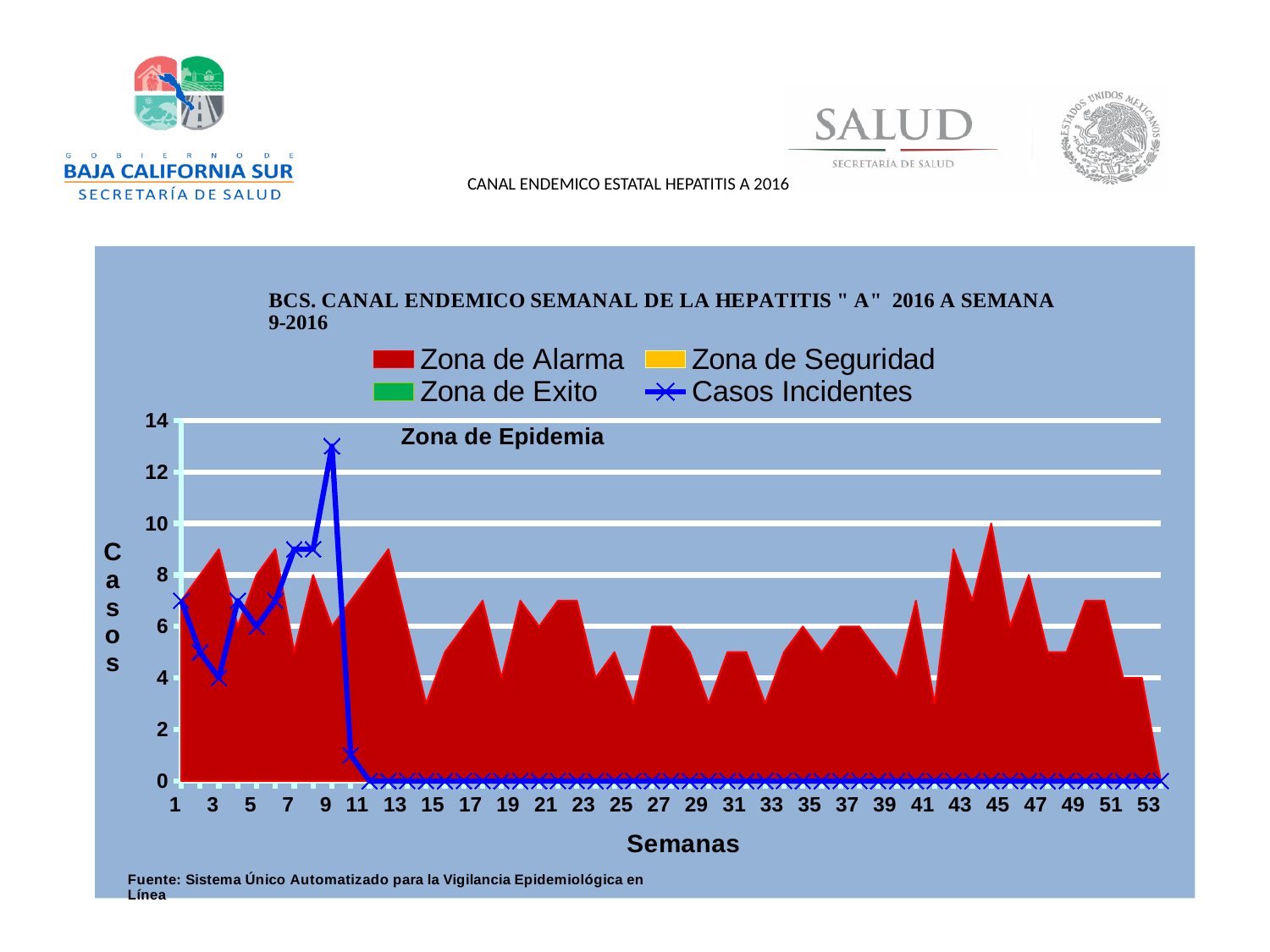
Which week has the larger Casos Incidentes value, week 1 or week 3? week 1 In which week does the Casos Incidentes line reach its highest value? 9 Is the Casos Incidentes value for week 9 greater or less than 12? greater What is the title of the x axis? Semanas What is the last week number labelled on the x axis? 53 What is the Casos Incidentes value for week 12? 0 Is the Zona de Alarma value for week 44 greater or less than 8? greater How many series does the legend list? 4 Do the Casos Incidentes values rise or fall from week 9 to week 12? fall Which legend entry is drawn as a blue line with x markers? Casos Incidentes What kind of chart is shown on the slide? area chart with a line series Is the Casos Incidentes value for week 3 greater or less than 6? less